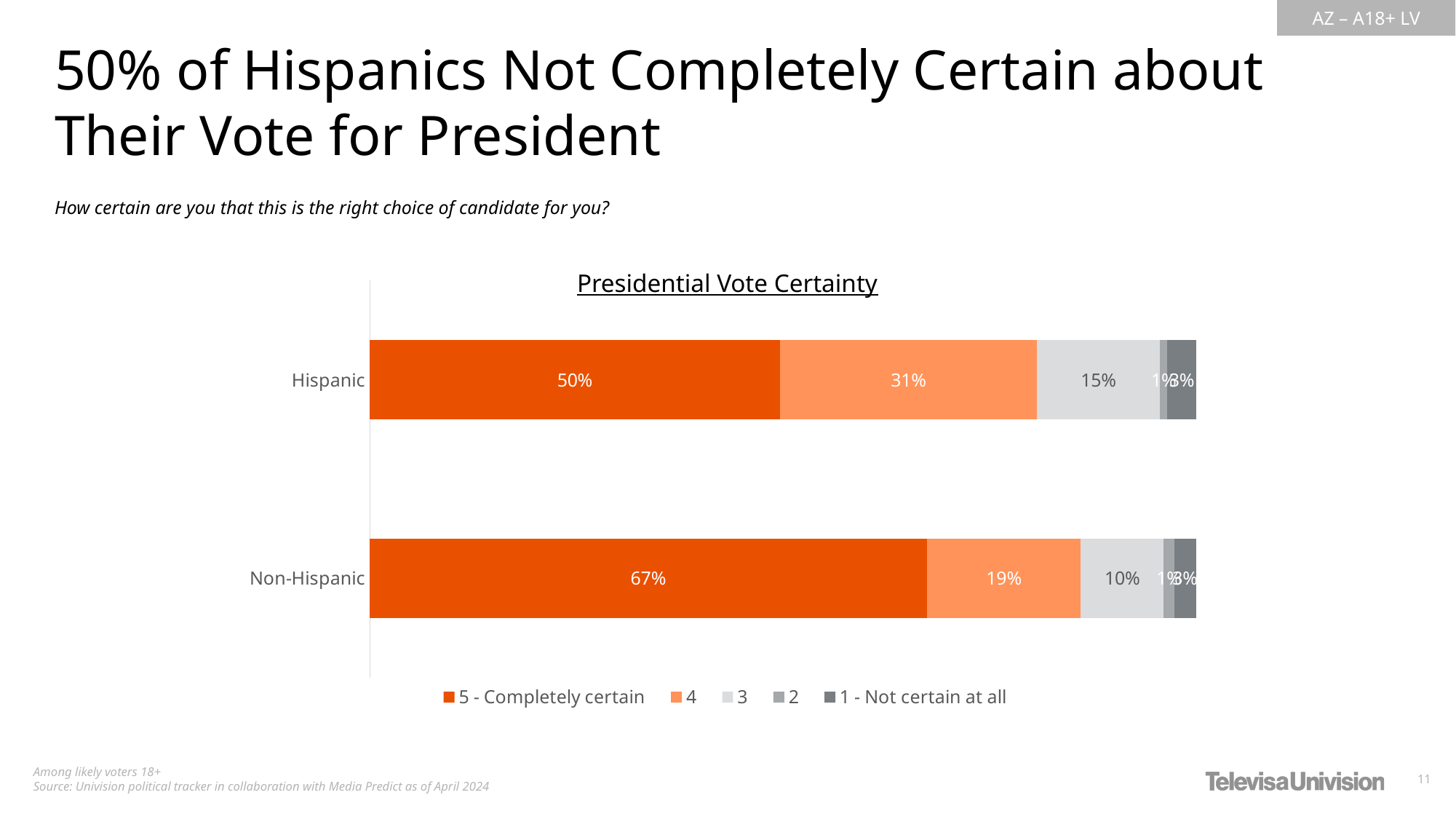
What share of Non-Hispanic respondents chose certainty level "3"? 10% How many percentage points higher is the "5 - Completely certain" share for Non-Hispanic than for Hispanic respondents? 17 percentage points What percentage of Non-Hispanic likely voters are "5 - Completely certain"? 67% How many series does the legend list? 5 What is the value for the "4" certainty level in the Hispanic bar? 31% What share of Hispanic respondents chose certainty level "3"? 15% What percentage of Hispanic likely voters are "5 - Completely certain" about their vote for president? 50% What type of chart is used to show Presidential Vote Certainty? Stacked bar chart Which group has the higher "5 - Completely certain" share? Non-Hispanic Which group has the larger share at certainty level "4", Hispanic or Non-Hispanic? Hispanic What is the value for the "4" certainty level in the Non-Hispanic bar? 19% How many groups (categories) are shown in the chart? 2